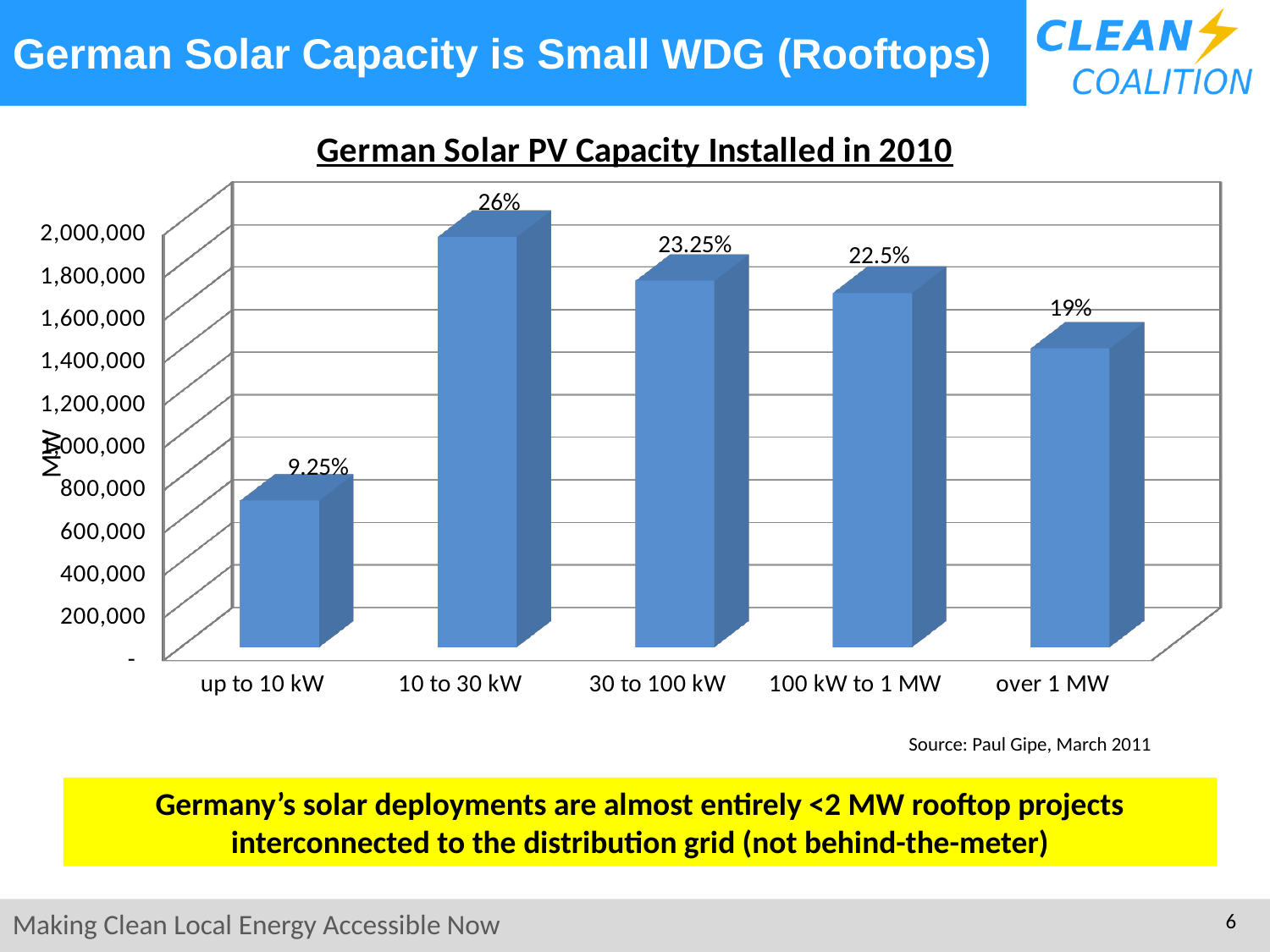
How many size categories are shown on the x axis? 5 What percentage label is shown on the bar for '30 to 100 kW'? 23.25% What percentage label is shown on the bar for '10 to 30 kW'? 26% What percentage label is shown on the bar for 'over 1 MW'? 19% Is the value for '10 to 30 kW' greater or less than 1,800,000 MW? greater Is the value for 'up to 10 kW' greater or less than 800,000 MW? less What is the difference in percentage points between the labels for '10 to 30 kW' and 'up to 10 kW'? 16.75% Which category has the lowest installed capacity? up to 10 kW Which has a larger share, '100 kW to 1 MW' or 'over 1 MW'? 100 kW to 1 MW Which category has the highest installed capacity? 10 to 30 kW What kind of chart is shown on the slide? Bar chart What percentage label is shown on the bar for 'up to 10 kW'? 9.25%